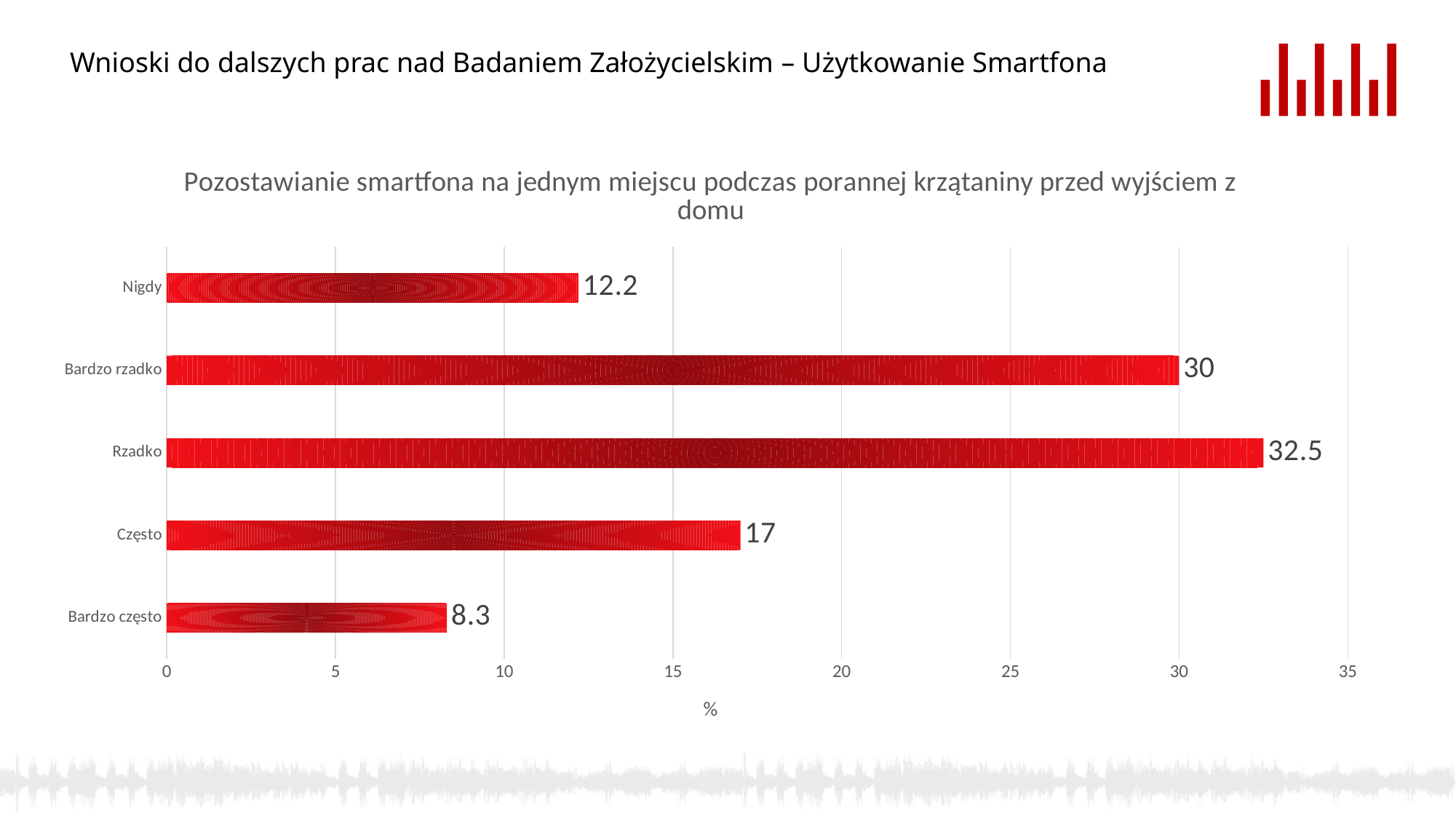
What is the difference between the values for Rzadko and Bardzo rzadko? 2.5 Which category has the lowest value? Bardzo często Which category has the highest value? Rzadko Which is larger, the value for Często or the value for Nigdy? Często What is the value for Rzadko? 32.5 What is the value for Bardzo często? 8.3 How many categories are shown in the chart? 5 What is the label on the horizontal axis? % What kind of chart is shown on the slide? Bar chart What is the value for Często? 17 What is the value for Nigdy? 12.2 What is the value for Bardzo rzadko? 30